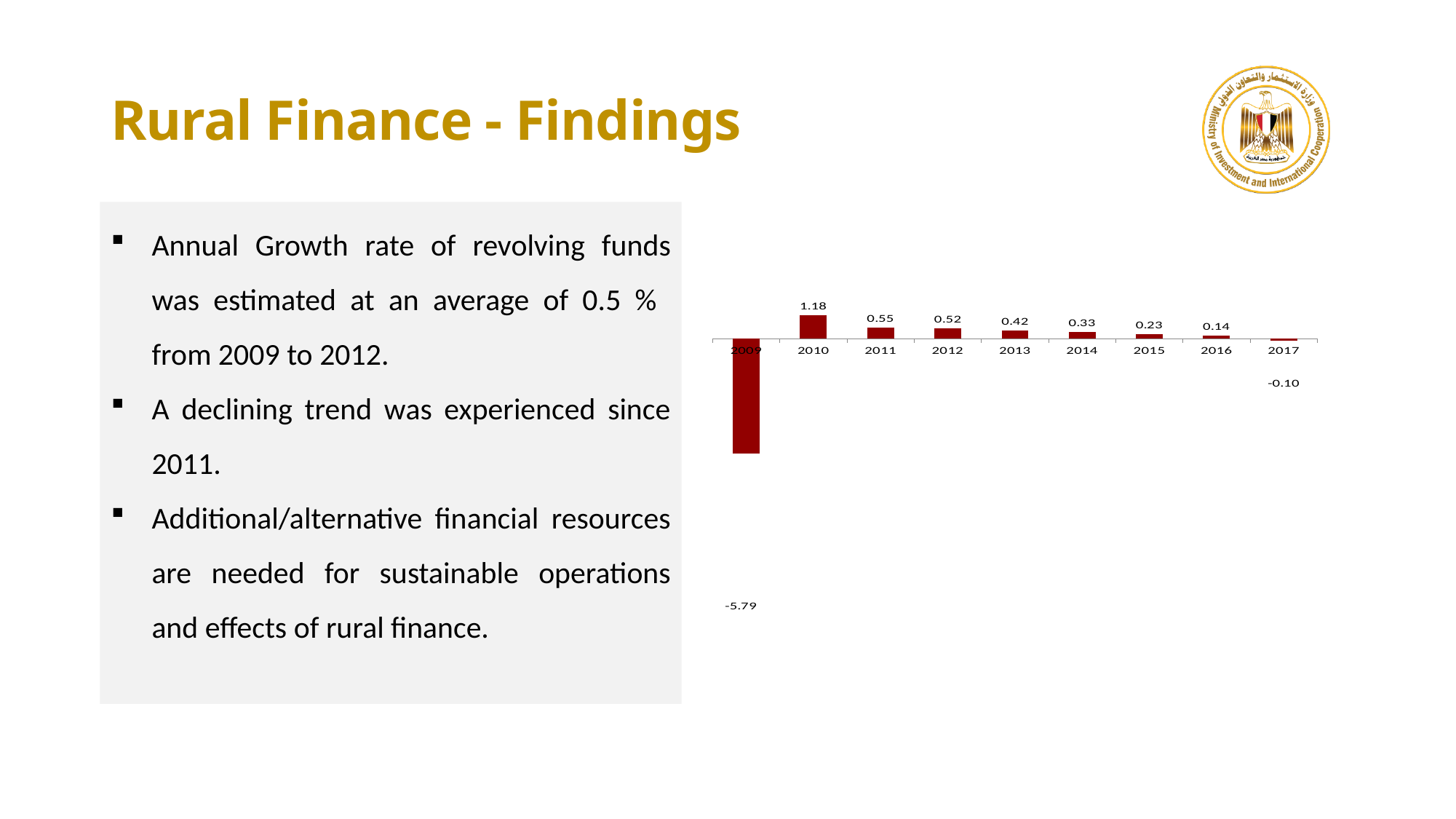
How many years are shown on the x axis? 9 Which year has the highest value? 2010 What colour are the bars in the chart? dark red What is the difference between the values for 2010 and 2011? 0.63 What is the value shown for 2017? -0.10 What kind of chart is shown? bar chart Which is larger, the value for 2012 or the value for 2014? 2012 What is the value shown for 2010? 1.18 What is the value shown for 2009? -5.79 What is the value shown for 2013? 0.42 Which year has the lowest value? 2009 Do the values rise or fall from 2010 to 2017? fall